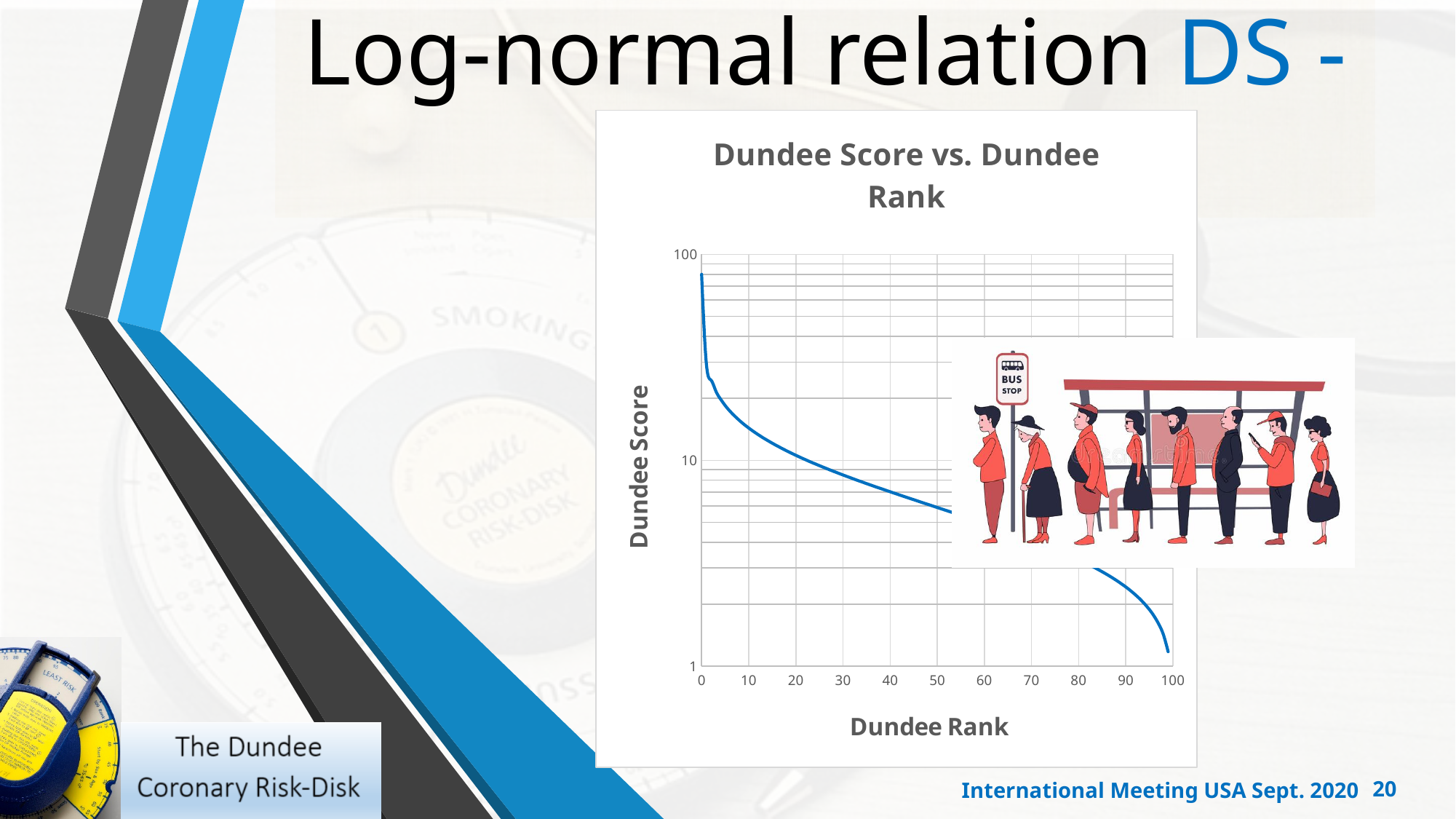
Is the highest Dundee Score on the chart greater or less than 100? less Is the Dundee Score higher at Dundee Rank 10 or at Dundee Rank 90? Dundee Rank 10 What is the highest value shown on the y axis of the chart? 100 Is the Dundee Score at Dundee Rank 50 greater or less than 10? less Is the Dundee Score at Dundee Rank 90 greater or less than 10? less Does the Dundee Score rise or fall as Dundee Rank increases? fall What is the label of the x axis of the chart? Dundee Rank Is the Dundee Score higher at Dundee Rank 30 or at Dundee Rank 50? Dundee Rank 30 What kind of chart is shown on the slide? line chart What is the title of the chart? Dundee Score vs. Dundee Rank